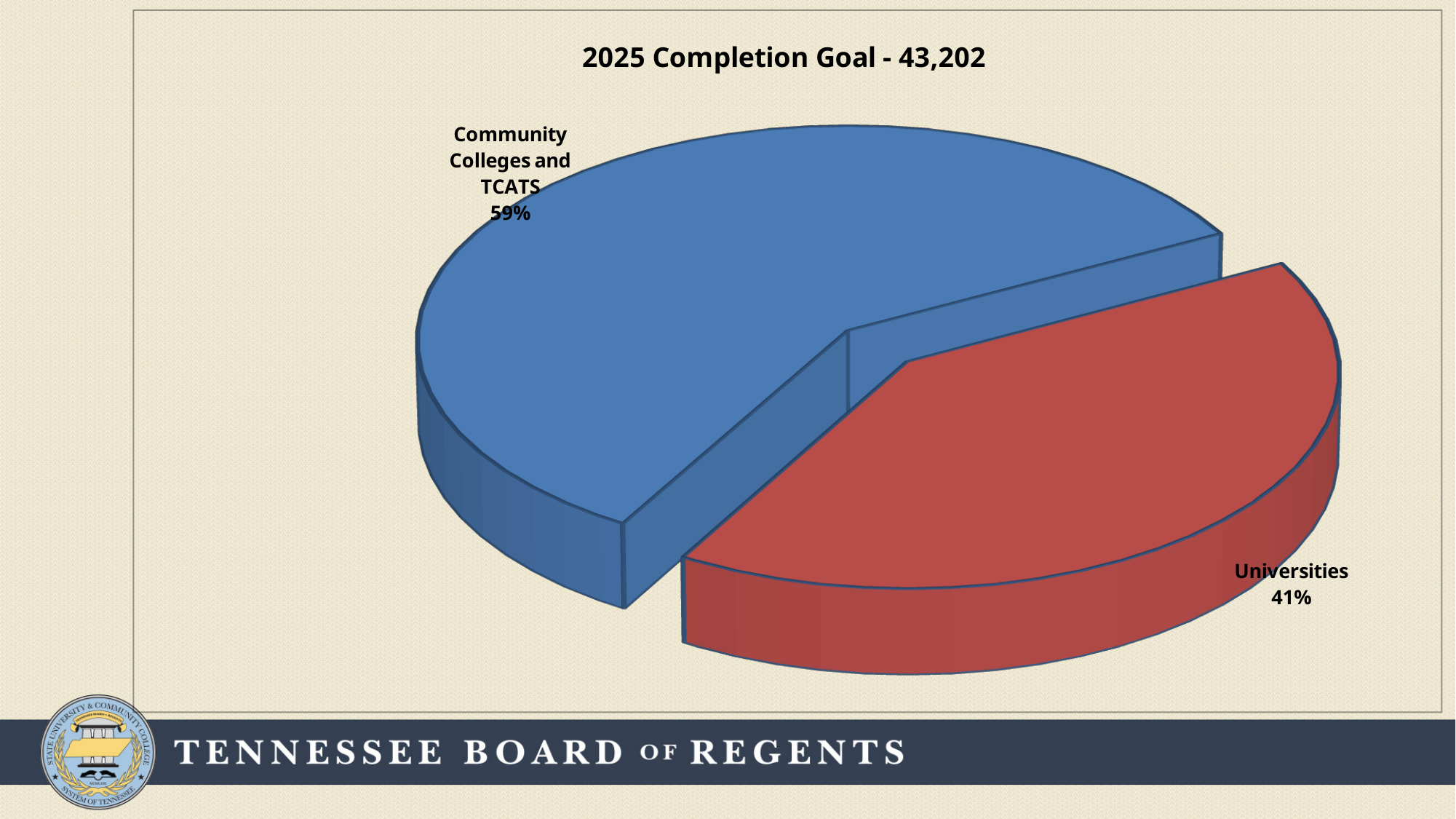
What is the total completion goal number shown in the chart title? 43,202 What is the title of the chart? 2025 Completion Goal - 43,202 What colour is the Universities slice? Red Which slice is the smallest? Universities What share of the pie does Universities represent? 41% Which is larger, the Universities slice or the Community Colleges and TCATS slice? Community Colleges and TCATS What kind of chart is shown on the slide? Pie chart What share of the pie does Community Colleges and TCATS represent? 59% Which slice is the largest? Community Colleges and TCATS How many slices does the pie chart have? 2 What is the difference in percentage points between the Community Colleges and TCATS slice and the Universities slice? 18